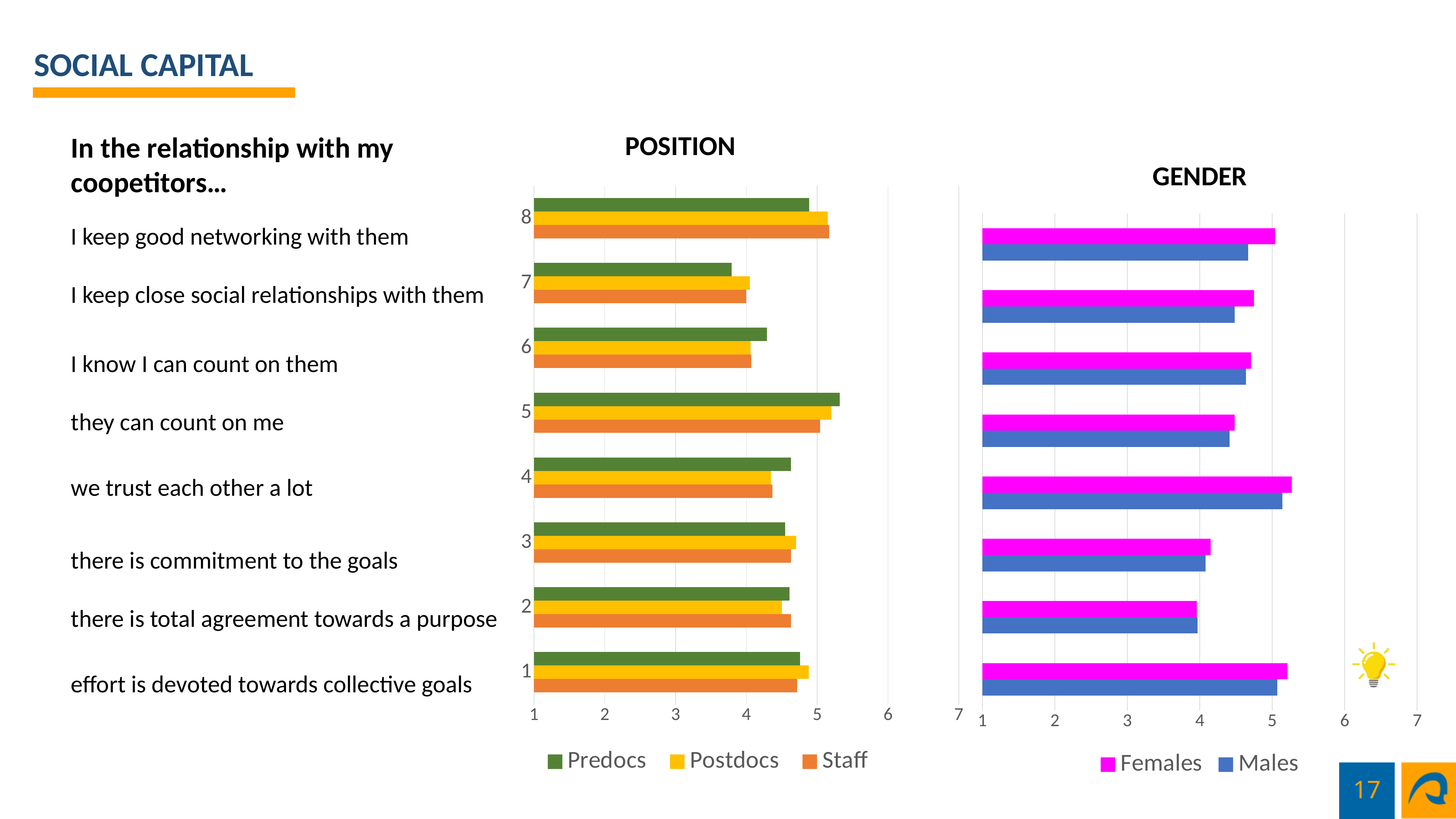
What kind of chart is the POSITION chart? bar chart In the POSITION chart, for category 7, which is larger: Predocs or Postdocs? Postdocs In the POSITION chart, for category 6, which is larger: Predocs or Staff? Predocs In the GENDER chart, which series is shown in magenta? Females How many series does the legend of the GENDER chart list? 2 How many series does the legend of the POSITION chart list? 3 In the POSITION chart, which category has the lowest Predocs value? 7 In the POSITION chart, is the Predocs value for category 5 greater or less than 5? greater In the POSITION chart, is the Predocs value for category 7 greater or less than 4? less In the POSITION chart, which category has the highest Predocs value? 5 In the GENDER chart, is the Males value for the topmost category greater or less than 5? less How many categories are shown on the vertical axis of the POSITION chart? 8